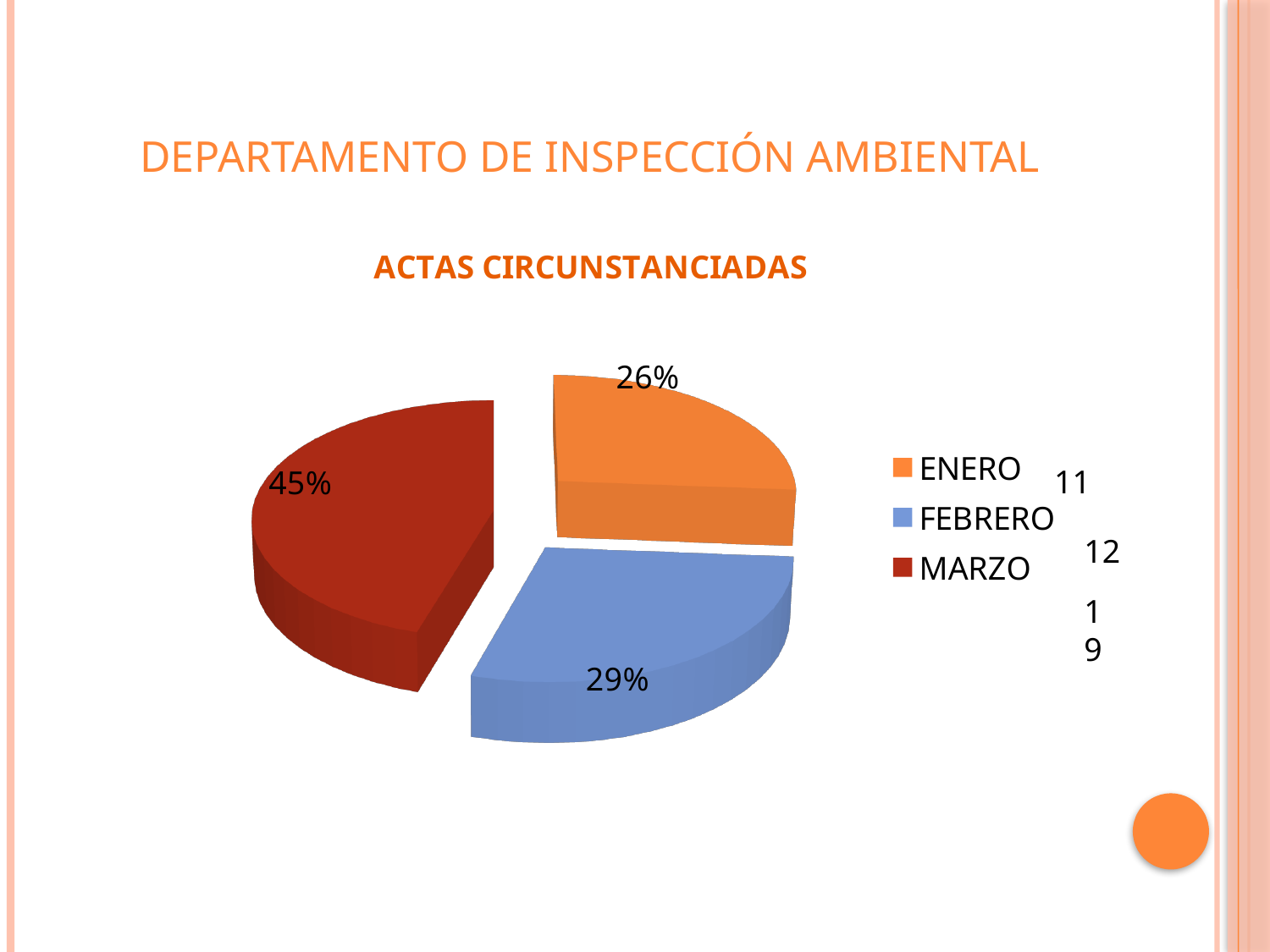
Which month has the largest slice of the pie? MARZO What is the difference in percentage points between the MARZO slice and the ENERO slice? 19 Which slice is larger, FEBRERO or ENERO? FEBRERO How many entries does the legend list? 3 How many slices does the pie chart have? 3 Which month has the smallest slice of the pie? ENERO What percentage of the pie does MARZO represent? 45% What percentage of the pie does FEBRERO represent? 29% What kind of chart is shown on the slide? Pie chart What percentage of the pie does ENERO represent? 26% What is the title of the chart? ACTAS CIRCUNSTANCIADAS What is the difference in percentage points between the FEBRERO slice and the ENERO slice? 3